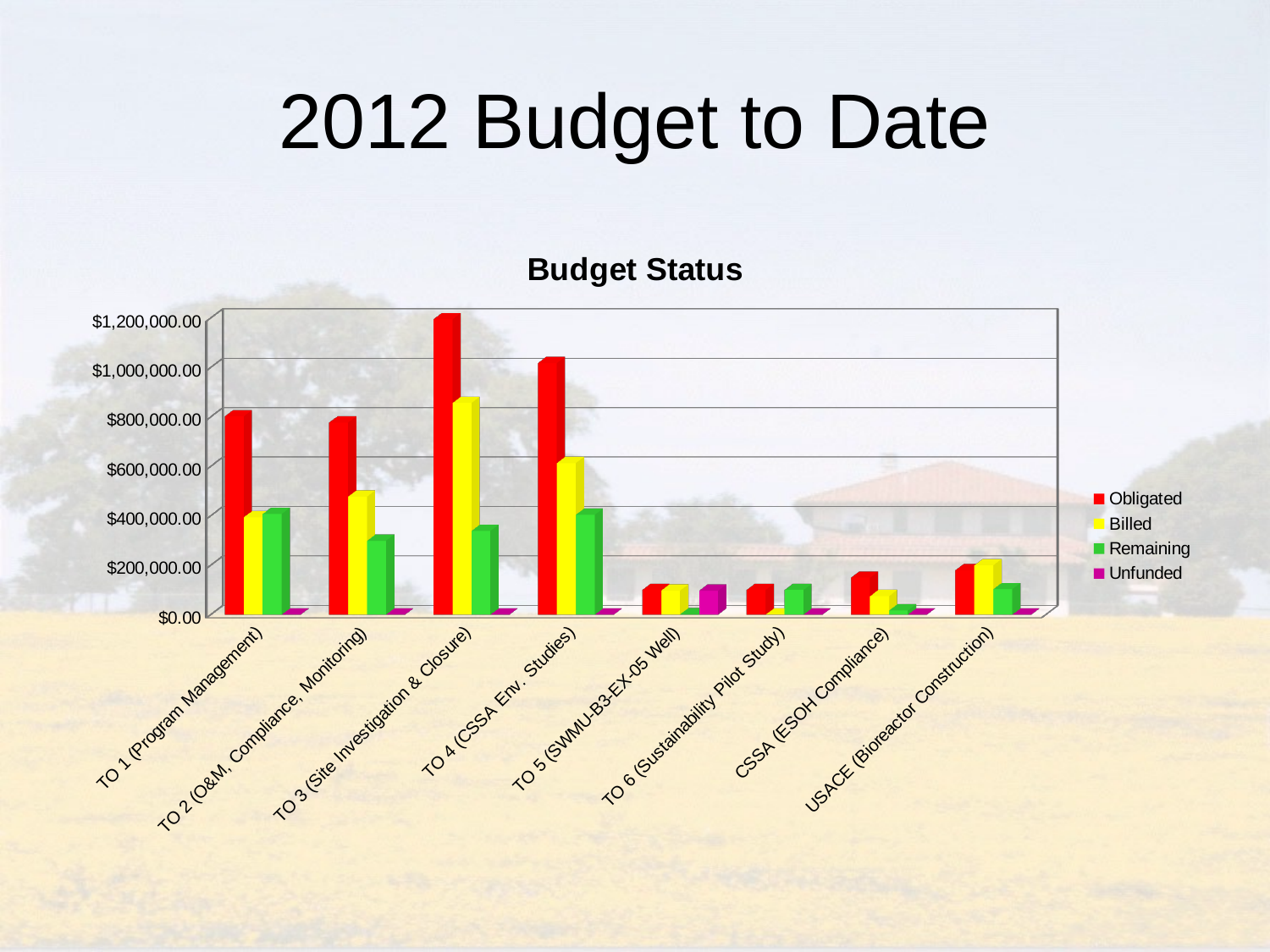
Is the Billed value for TO 2 (O&M, Compliance, Monitoring) greater or less than $600,000.00? less What kind of chart is shown on the slide? Bar chart Which category has the largest Unfunded value? TO 5 (SWMU-B3-EX-05 Well) Is the Billed value for TO 3 (Site Investigation & Closure) greater or less than $600,000.00? greater Which is larger for TO 2 (O&M, Compliance, Monitoring), the Billed value or the Remaining value? Billed Which is larger, the Obligated value for TO 3 (Site Investigation & Closure) or for TO 4 (CSSA Env. Studies)? TO 3 (Site Investigation & Closure) What is the title of the chart on the slide? Budget Status Is the Remaining value for TO 2 (O&M, Compliance, Monitoring) greater or less than $400,000.00? less How many series does the legend of the Budget Status chart list? 4 Which category has the highest Obligated value? TO 3 (Site Investigation & Closure) How many categories (task orders/projects) are shown on the x axis of the Budget Status chart? 8